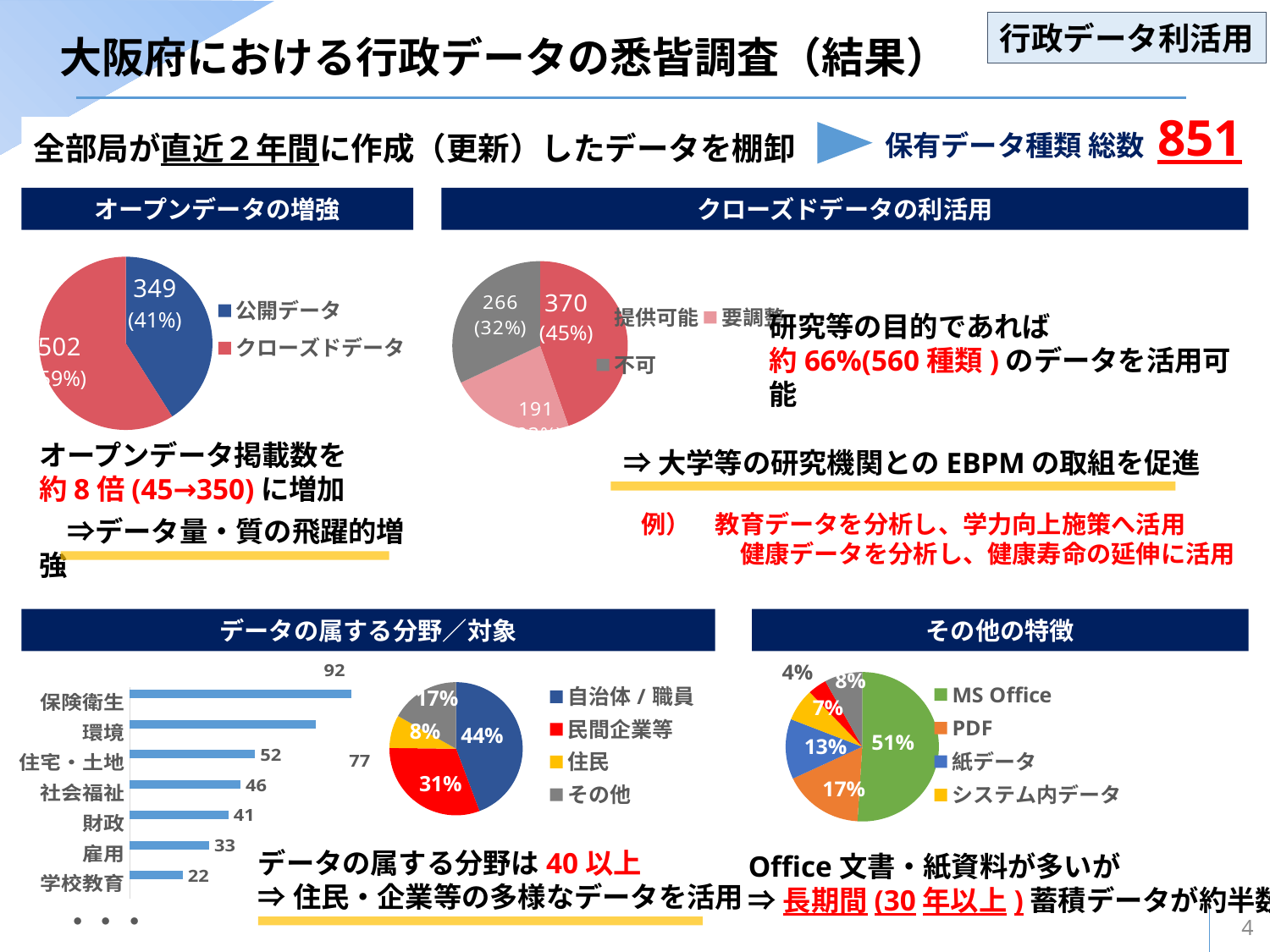
What kind of chart is the chart on the bottom left under 「データの属する分野／対象」? bar chart In the pie chart next to the bar chart under 「データの属する分野／対象」, which category has the largest share? 自治体／職員 In the bar chart under 「データの属する分野／対象」, what is the difference between the values for 保険衛生 and 学校教育? 70 In the bar chart under 「データの属する分野／対象」, how many categories are plotted? 7 In the pie chart next to the bar chart under 「データの属する分野／対象」, what share is shown for 民間企業等? 31% In the bar chart under 「データの属する分野／対象」, which category has the highest value? 保険衛生 In the pie chart under 「クローズドデータの利活用」, what value is shown for 提供可能? 370 In the pie chart under 「オープンデータの増強」, what share of the pie does クローズドデータ take? 59% In the pie chart under 「オープンデータの増強」, what value is shown for 公開データ? 349 In the pie chart under 「クローズドデータの利活用」, what value is shown for 不可? 266 In the pie chart under 「クローズドデータの利活用」, how many entries does the legend list? 3 In the pie chart under 「その他の特徴」, what share is shown for MS Office? 51%